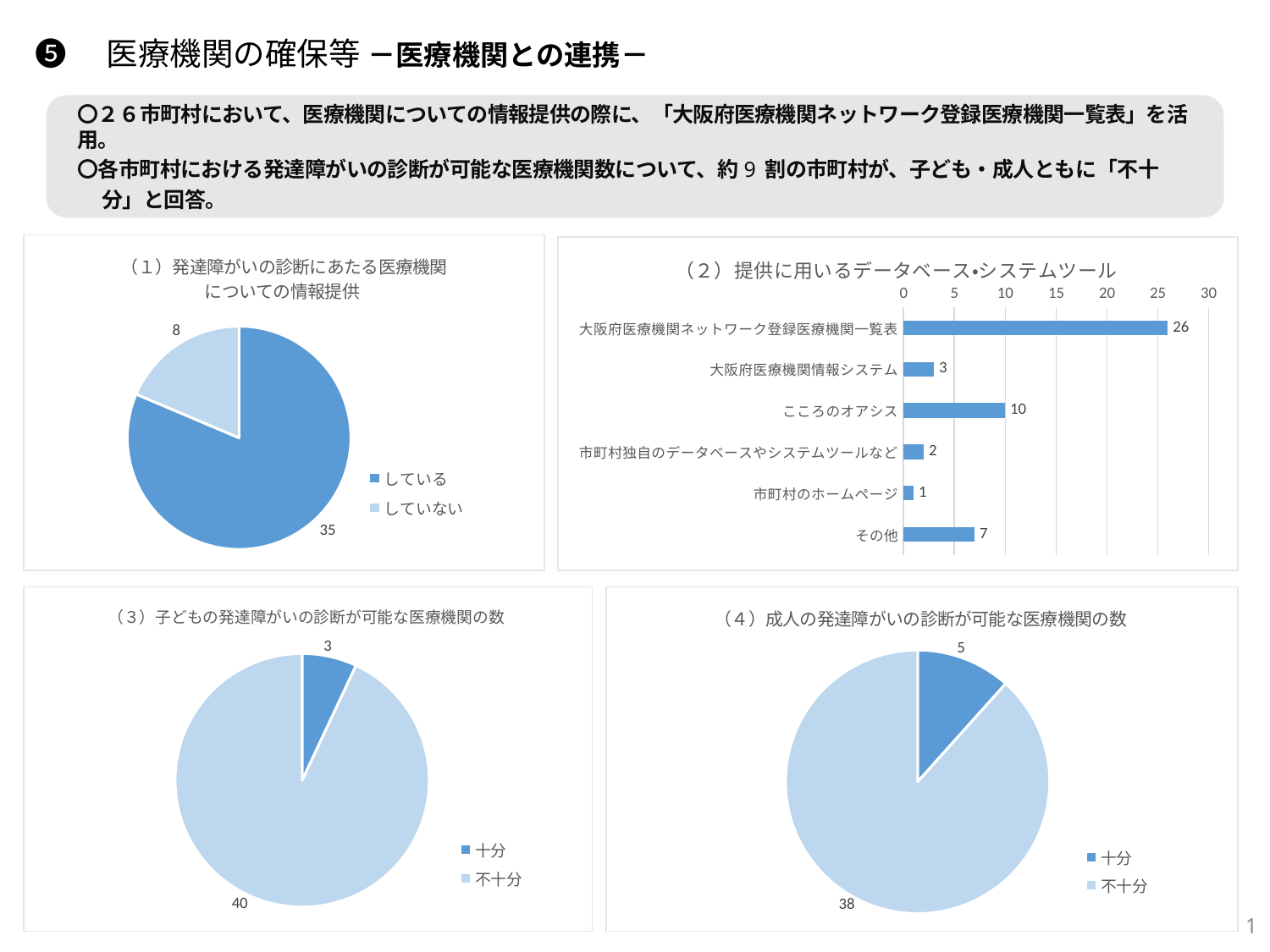
In chart (1) 発達障がいの診断にあたる医療機関についての情報提供, what is the difference between している and していない? 27 In chart (2) 提供に用いるデータベース・システムツール, how many categories are shown? 6 In chart (4) 成人の発達障がいの診断が可能な医療機関の数, what is the value for 十分? 5 In chart (3) 子どもの発達障がいの診断が可能な医療機関の数, what is the value for 不十分? 40 In chart (2) 提供に用いるデータベース・システムツール, what is the value for こころのオアシス? 10 In chart (2) 提供に用いるデータベース・システムツール, which category has the lowest value? 市町村のホームページ In chart (2) 提供に用いるデータベース・システムツール, which category has the highest value? 大阪府医療機関ネットワーク登録医療機関一覧表 In chart (1) 発達障がいの診断にあたる医療機関についての情報提供, what is the value for していない? 8 In chart (1) 発達障がいの診断にあたる医療機関についての情報提供, what is the value for している? 35 In chart (2) 提供に用いるデータベース・システムツール, which is larger: その他 or 大阪府医療機関情報システム? その他 In chart (4) 成人の発達障がいの診断が可能な医療機関の数, how many entries does the legend list? 2 What kind of chart is chart (2) 提供に用いるデータベース・システムツール? bar chart